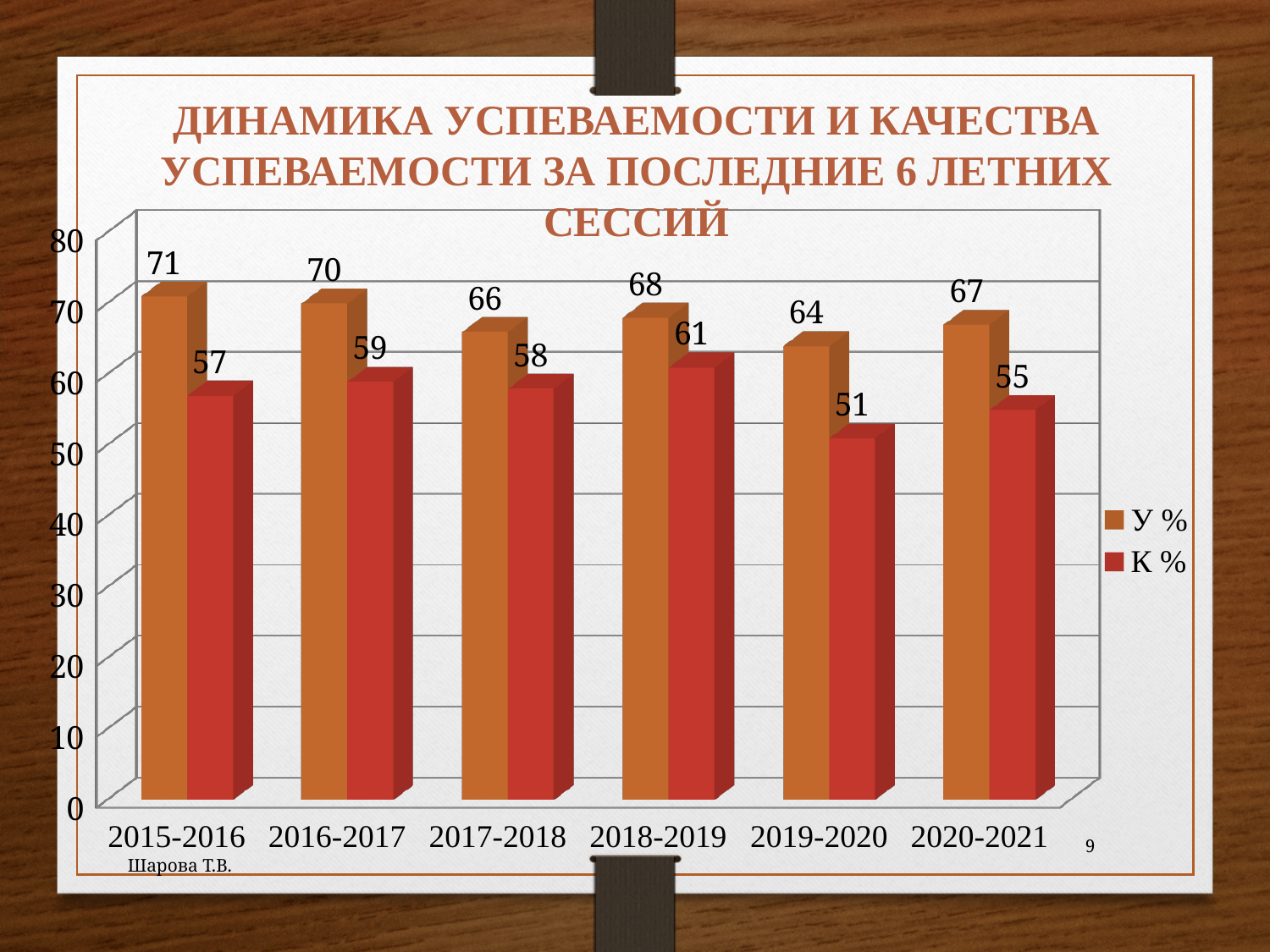
What kind of chart is shown on the slide? Bar chart What is the difference between У % and К % for 2020-2021? 12 What is the value of У % for 2015-2016? 71 Which is larger: К % for 2016-2017 or К % for 2017-2018? К % for 2016-2017 What are the two series named in the legend? У % and К % Which academic year has the highest У % value? 2015-2016 How many academic years are shown on the x axis? 6 How many series does the legend list? 2 Does the У % value rise or fall from 2015-2016 to 2019-2020? Fall What is the value of К % for 2018-2019? 61 Which academic year has the lowest К % value? 2019-2020 What is the value of К % for 2019-2020? 51